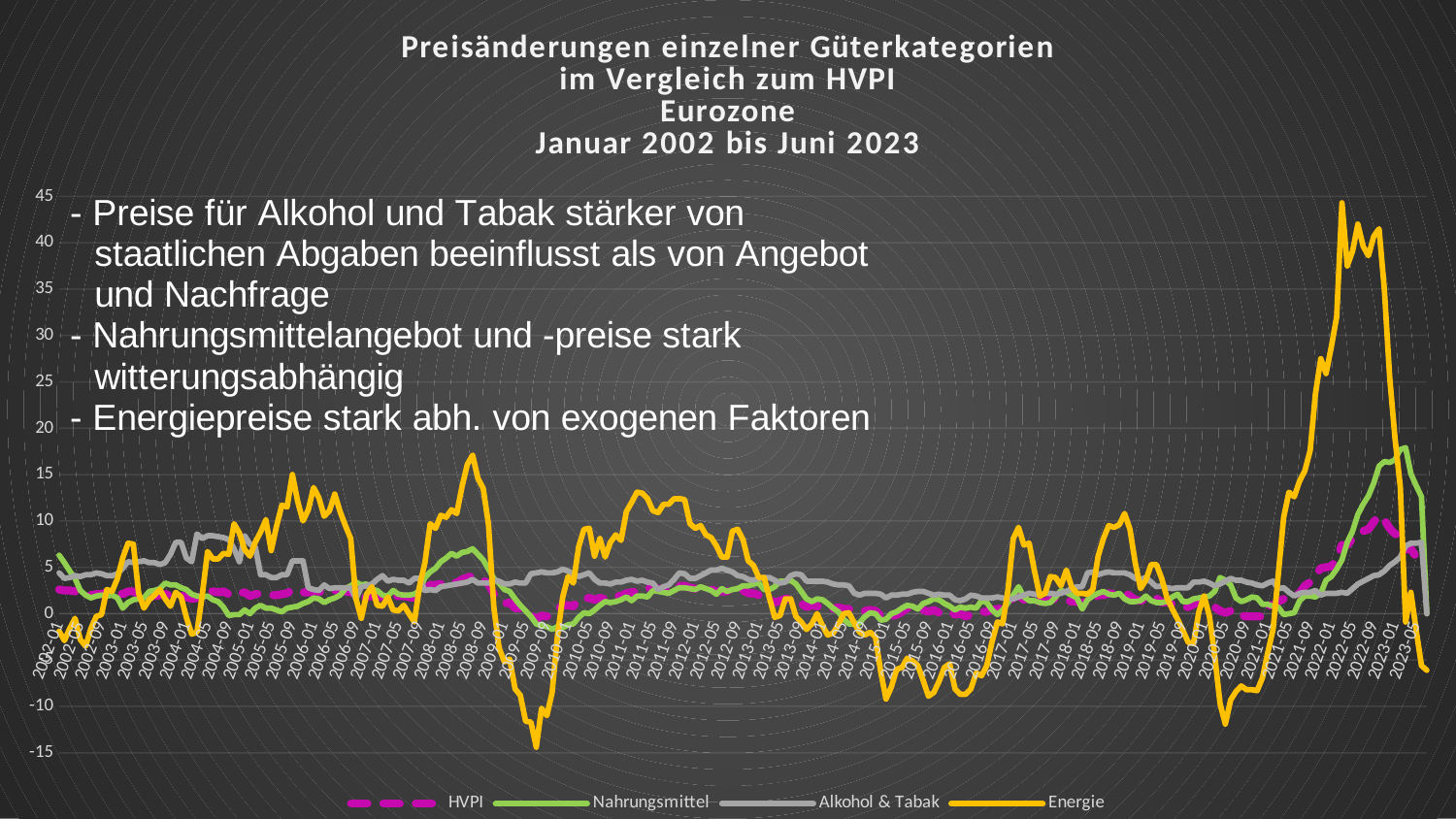
At the 2022 peak, which series is higher: Energie or Nahrungsmittel? Energie Which series reaches the lowest value anywhere on the chart? Energie What is the title of the chart? Preisänderungen einzelner Güterkategorien im Vergleich zum HVPI Eurozone Januar 2002 bis Juni 2023 What is the highest value shown on the vertical axis? 45 Is the lowest value of the Energie series around 2009 greater or less than -10? less What kind of chart is shown on the slide? line chart Is the peak value of the HVPI series in 2022 greater or less than 5? greater Does the Energie line rise or fall between 2021-01 and 2022-05? rise How many series does the legend list? 4 Which series are listed in the legend? HVPI, Nahrungsmittel, Alkohol & Tabak, Energie Which series reaches the highest value anywhere on the chart? Energie Is the peak value of the Energie series in 2022 greater or less than 40? greater